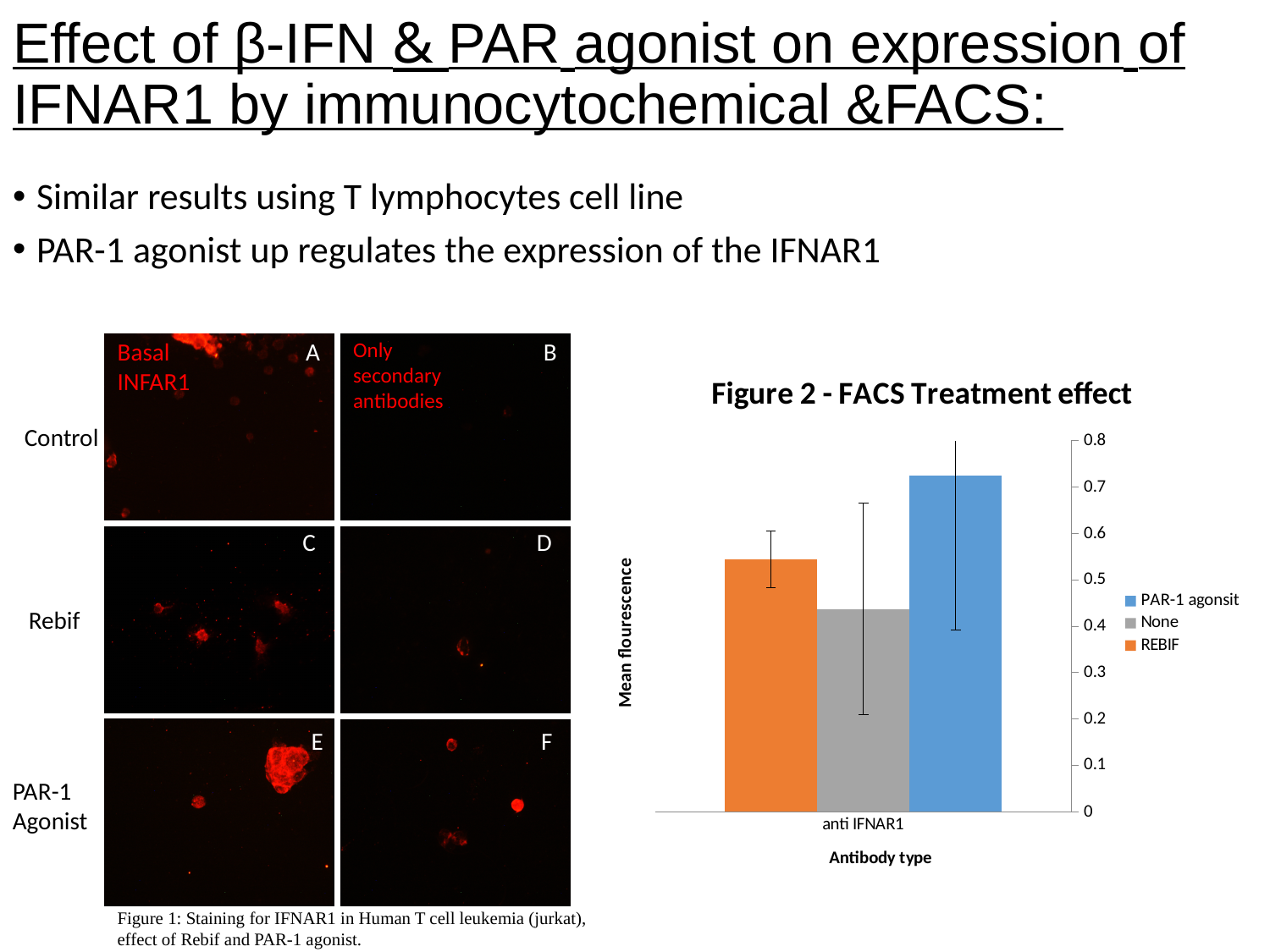
In Figure 2 - FACS Treatment effect, which series has the highest mean fluorescence? PAR-1 agonsit What is the label of the single category on the x axis of Figure 2 - FACS Treatment effect? anti IFNAR1 How many series does the legend of Figure 2 - FACS Treatment effect list? 3 How many categories are shown on the x axis of Figure 2 - FACS Treatment effect? 1 In Figure 2 - FACS Treatment effect, which series has the lowest mean fluorescence? None What kind of chart is Figure 2 - FACS Treatment effect? bar chart In Figure 2 - FACS Treatment effect, which is larger, the REBIF bar or the None bar? REBIF In Figure 2 - FACS Treatment effect, is the value for PAR-1 agonsit greater or less than 0.6? greater In Figure 2 - FACS Treatment effect, is the value for None greater or less than 0.5? less What is the y-axis title of Figure 2 - FACS Treatment effect? Mean flourescence In Figure 2 - FACS Treatment effect, is the value for REBIF greater or less than 0.5? greater